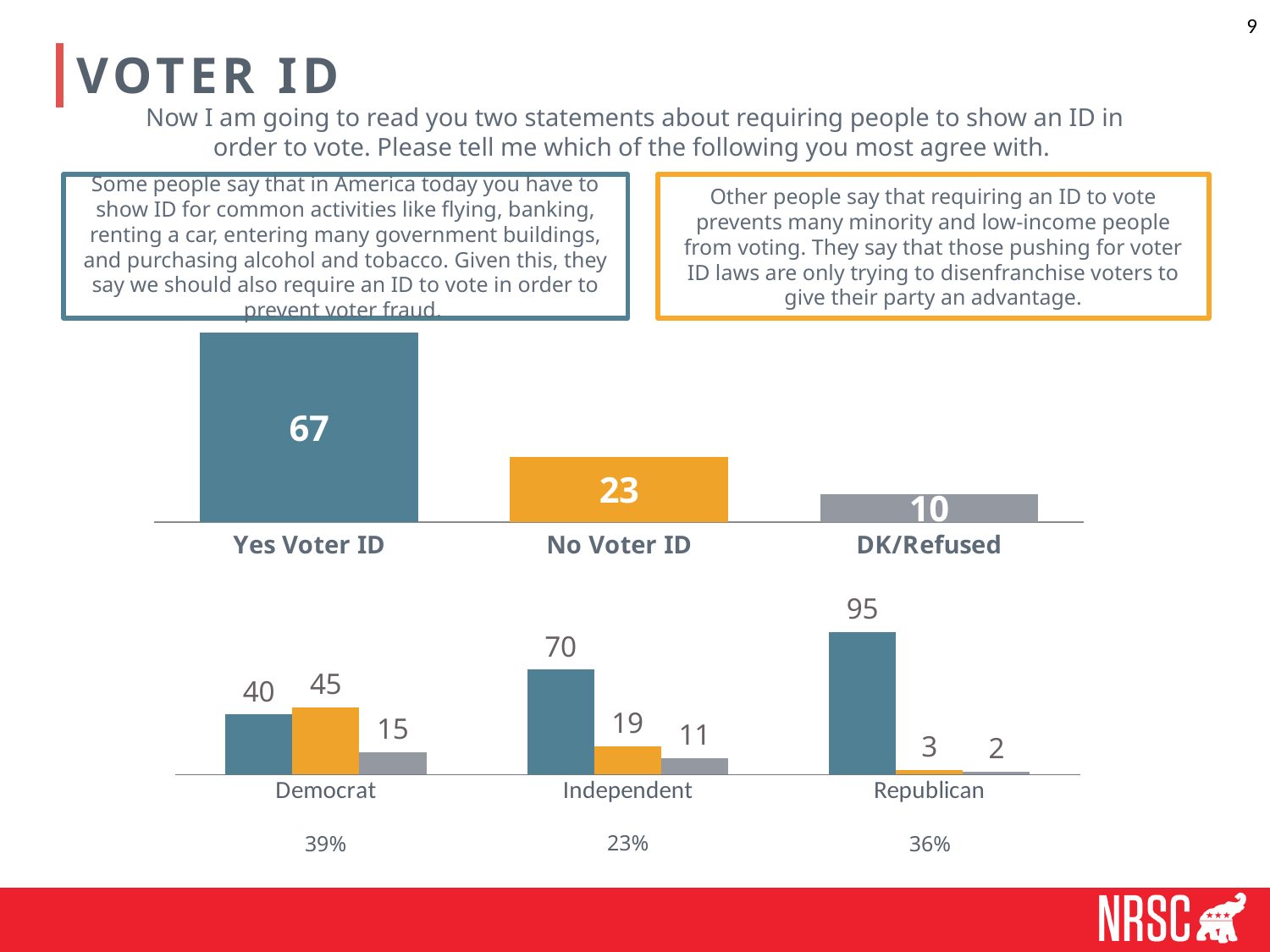
In the top chart, how many categories are shown? 3 In the bottom chart, is the blue bar for Democrat larger or smaller than the orange bar for Democrat? Smaller In the bottom chart, what is the value of the blue bar for Republican? 95 In the bottom chart, what is the value of the orange bar for Democrat? 45 In the top chart, what is the value for Yes Voter ID? 67 In the top chart, what is the value for No Voter ID? 23 In the bottom chart, what is the value of the gray bar for Independent? 11 In the bottom chart, what is the difference between the blue bar and the orange bar for Independent? 51 In the top chart, what is the difference between Yes Voter ID and No Voter ID? 44 What kind of chart is the top chart? Bar chart In the top chart, which category has the lowest value? DK/Refused In the bottom chart, which party has the highest blue bar? Republican